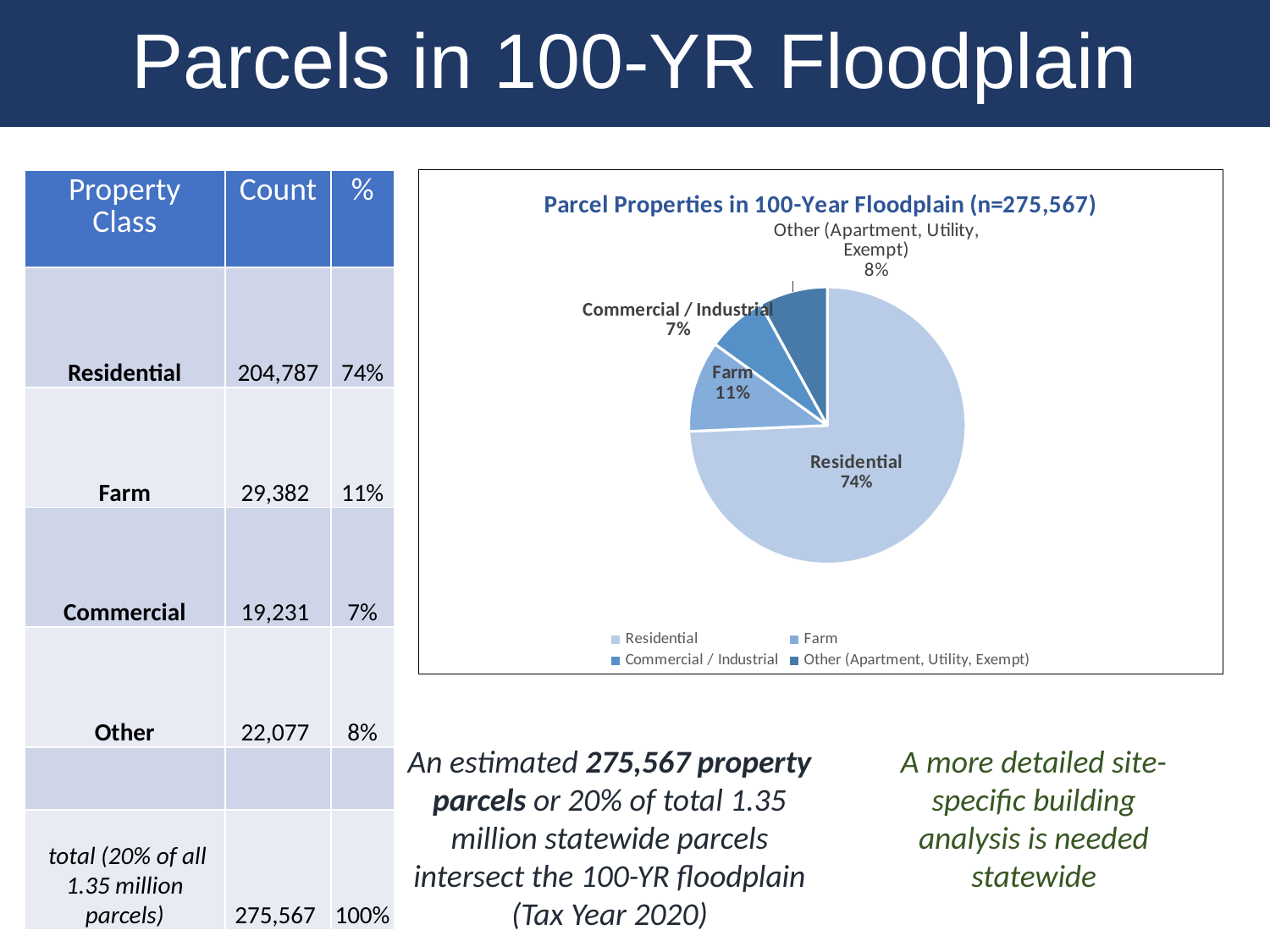
What share of the pie does Commercial / Industrial represent? 7% How many entries does the legend of the pie chart list? 4 What share of the pie does Residential represent? 74% What is the title of the pie chart? Parcel Properties in 100-Year Floodplain (n=275,567) Which slice of the pie chart is the largest? Residential Which slice is larger, Farm or Other (Apartment, Utility, Exempt)? Farm What share of the pie does Other (Apartment, Utility, Exempt) represent? 8% How many slices does the pie chart have? 4 What is the difference in percentage points between the Residential and Farm slices? 63 What kind of chart is shown on the slide? pie chart Which slice of the pie chart is the smallest? Commercial / Industrial